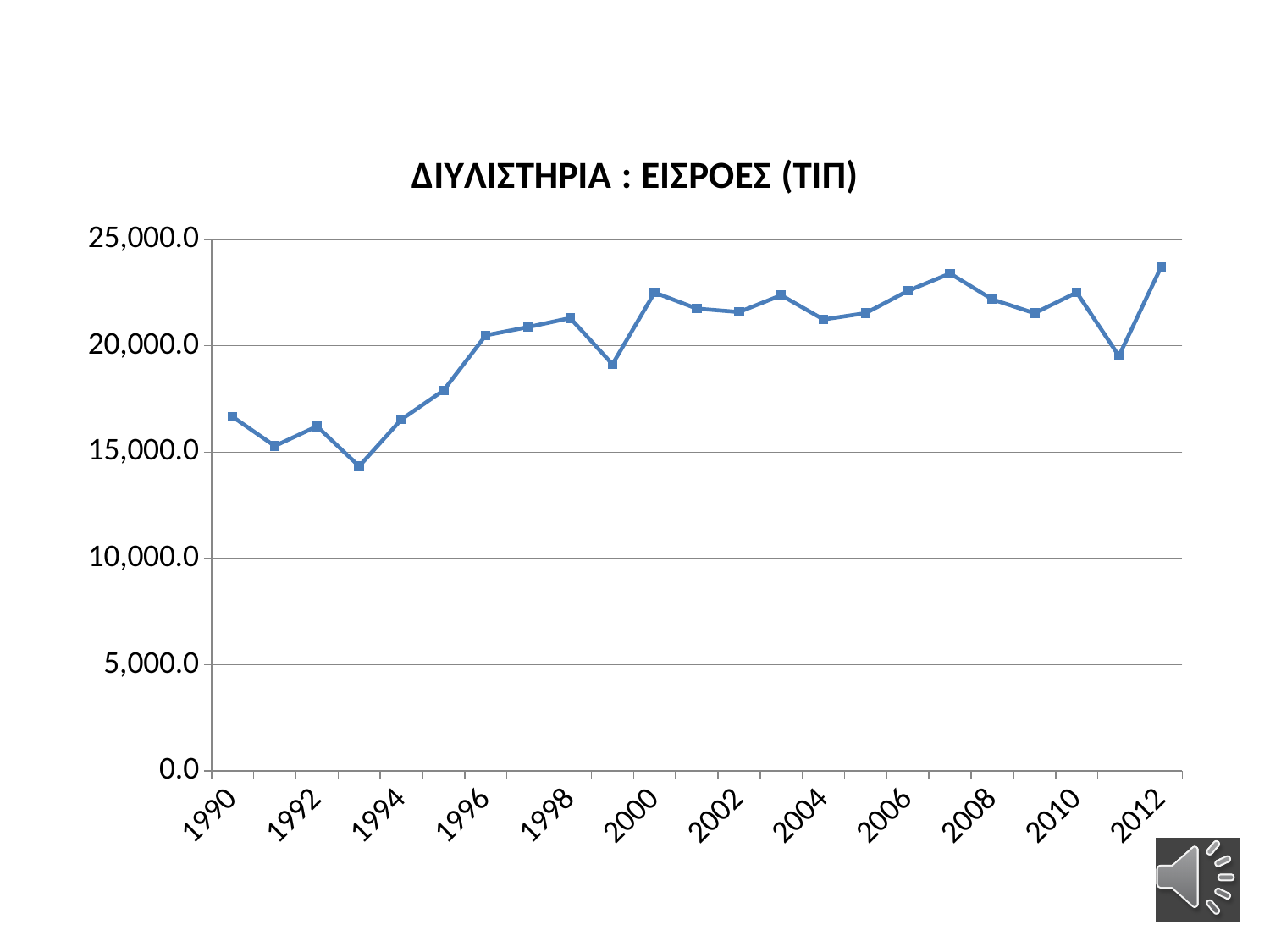
What is the title of the chart? ΔΙΥΛΙΣΤΗΡΙΑ : ΕΙΣΡΟΕΣ (ΤΙΠ) Which is larger, the value for 1999 or the value for 2000? 2000 What kind of chart is shown on the slide? line chart Which is larger, the value for 1990 or the value for 1993? 1990 Is the value for 1990 greater or less than 15,000? greater Is the value for 2011 greater or less than 20,000? less Is the value for 1999 greater or less than 20,000? less Which year has the lowest value on the chart? 1993 Overall, do the values rise or fall from 1990 to 2012? rise How many data points are plotted on the line? 23